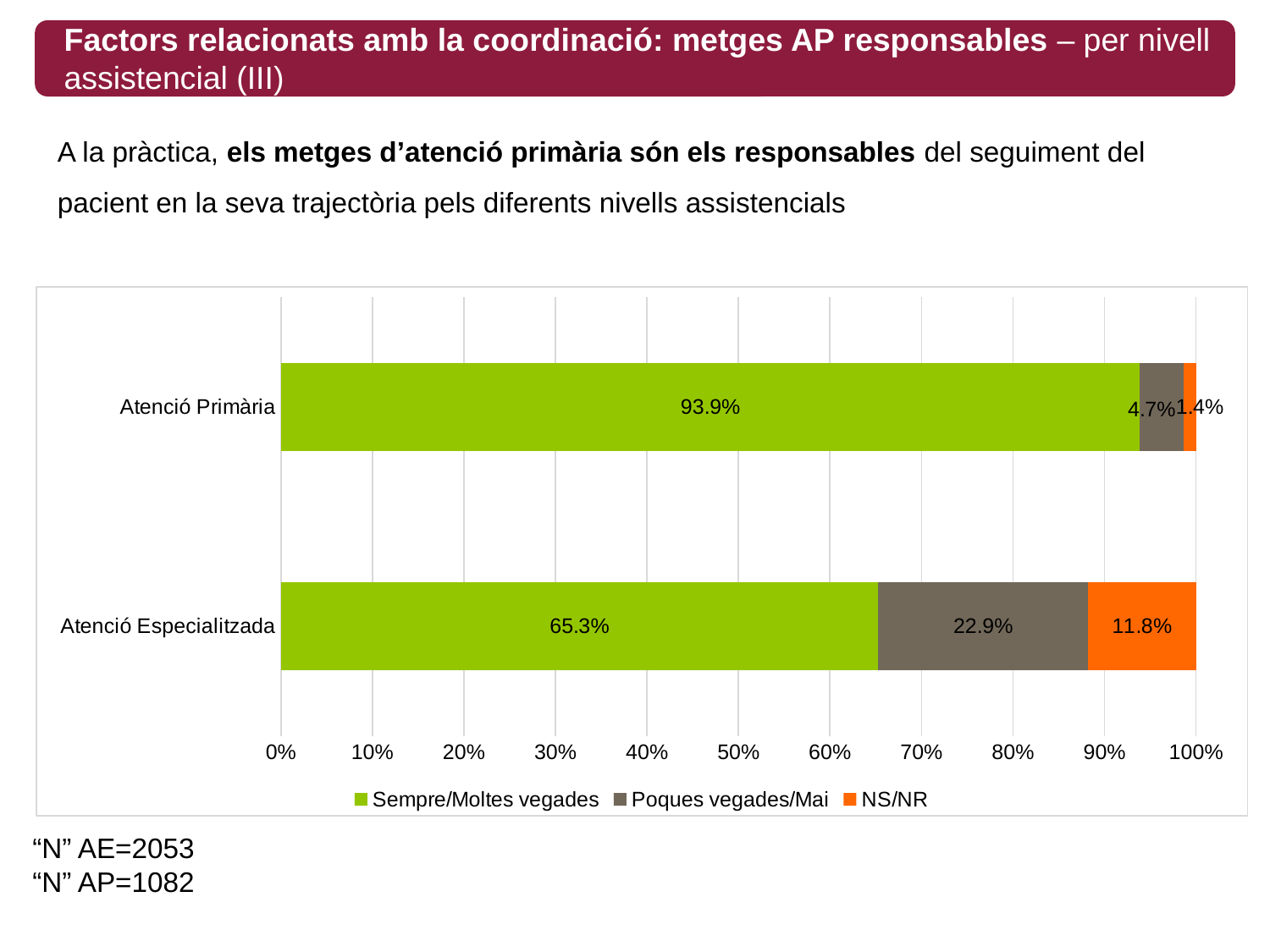
What kind of chart is shown on the slide? Stacked bar chart What is the difference between the Sempre/Moltes vegades values for Atenció Primària and Atenció Especialitzada? 28.6% What is the value of Sempre/Moltes vegades for Atenció Primària? 93.9% What is the value of Poques vegades/Mai for Atenció Especialitzada? 22.9% How many series does the legend list? 3 Which category has the lower NS/NR value? Atenció Primària What is the Poques vegades/Mai value for Atenció Primària? 4.7% Is the Sempre/Moltes vegades value for Atenció Especialitzada greater or less than 60%? greater What is the NS/NR value for Atenció Especialitzada? 11.8% How many categories are shown on the y axis of the chart? 2 Is the Poques vegades/Mai value larger for Atenció Especialitzada or Atenció Primària? Atenció Especialitzada Which category has the higher Sempre/Moltes vegades value? Atenció Primària